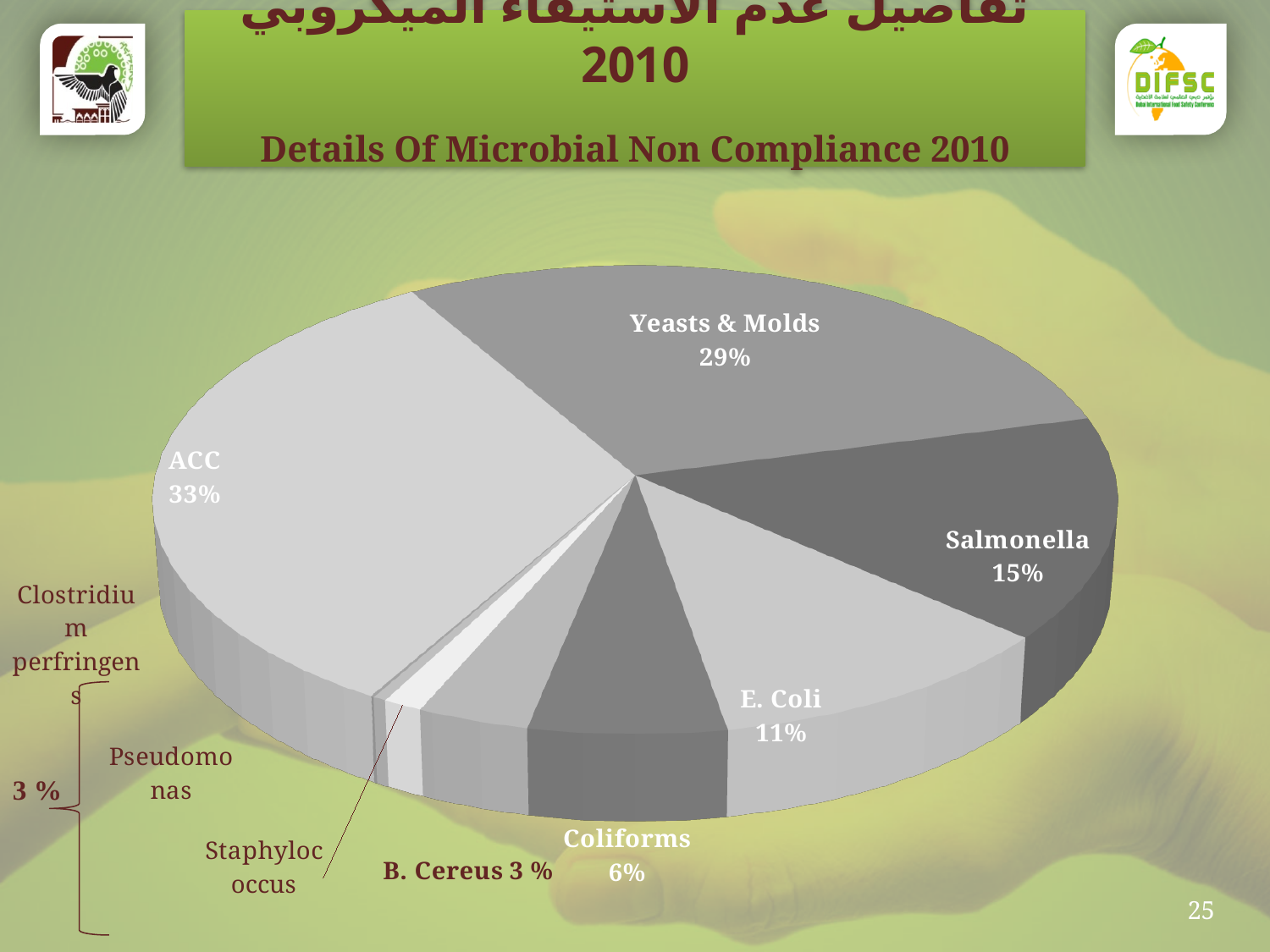
What percentage of microbial non compliance is attributed to ACC? 33% What type of chart is shown on the slide? Pie chart What is the title of the chart in English? Details Of Microbial Non Compliance 2010 Which category has the largest share of the pie? ACC By how many percentage points does ACC exceed Yeasts & Molds? 4 percentage points What is the value for Coliforms? 6% What percentage is shown for B. Cereus? 3 % Which is larger, the share for Salmonella or the share for E. Coli? Salmonella What percentage is shown for E. Coli? 11% What is the difference between the Yeasts & Molds share and the Salmonella share? 14 percentage points What share does Yeasts & Molds have in the pie chart? 29% What is the value shown for Salmonella? 15%